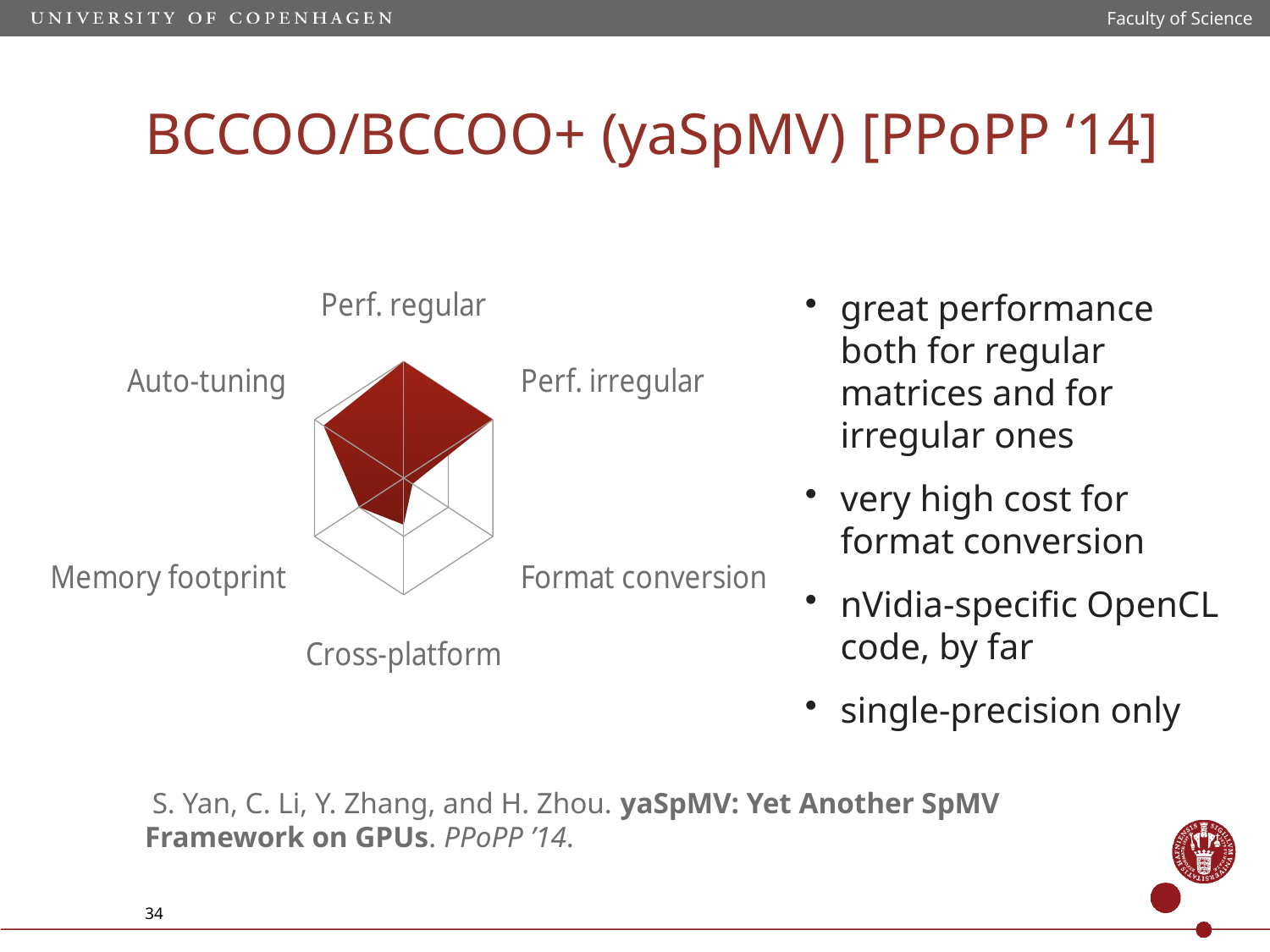
Which is larger on the radar chart, Perf. regular or Memory footprint? Perf. regular Which is larger on the radar chart, Auto-tuning or Cross-platform? Auto-tuning What kind of chart is shown on the slide? Radar chart Which is larger on the radar chart, Perf. irregular or Memory footprint? Perf. irregular Which category is at the top of the radar chart? Perf. regular Which category is at the bottom of the radar chart? Cross-platform How many categories (axes) does the radar chart have? 6